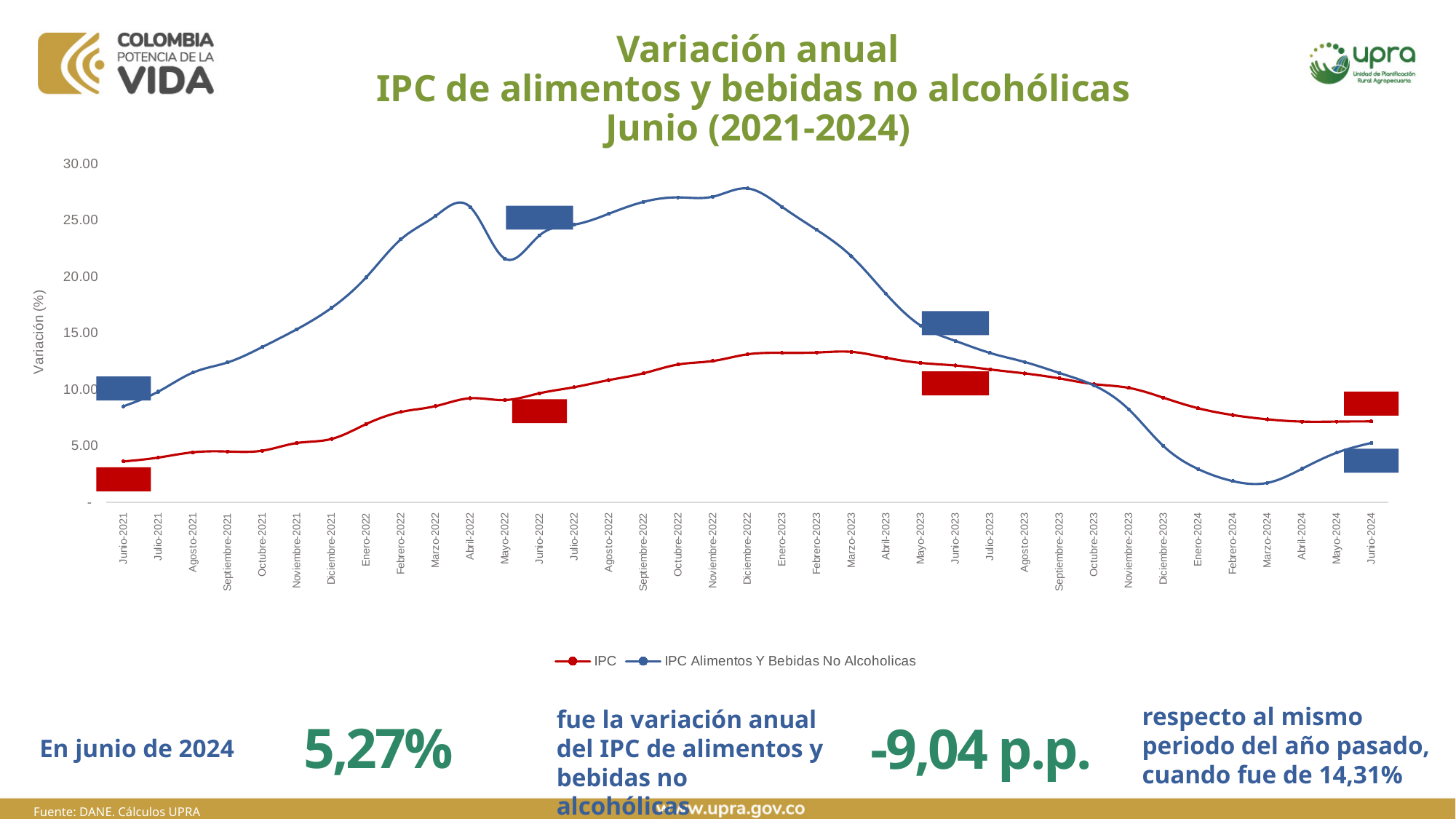
What was the annual variation of the IPC de alimentos y bebidas no alcohólicas in June 2023? 14,31% Does the IPC Alimentos Y Bebidas No Alcoholicas series rise or fall between Diciembre-2022 and Marzo-2024? fall What are the two series named in the legend? IPC; IPC Alimentos Y Bebidas No Alcoholicas By how many percentage points did the annual variation of the IPC de alimentos y bebidas no alcohólicas change from June 2023 to June 2024? -9,04 p.p. Is the value of the IPC Alimentos Y Bebidas No Alcoholicas series in Diciembre-2022 greater or less than 25.00? greater How many series does the legend list? 2 What kind of chart is shown on the slide? line chart How many months are plotted along the x axis, from Junio-2021 to Junio-2024? 37 In which month does the IPC Alimentos Y Bebidas No Alcoholicas series reach its highest value? Diciembre-2022 Is the value of the IPC series in Junio-2021 greater or less than 5.00? less In Marzo-2024, which series has the higher value, IPC or IPC Alimentos Y Bebidas No Alcoholicas? IPC What was the annual variation of the IPC de alimentos y bebidas no alcohólicas in June 2024? 5,27%